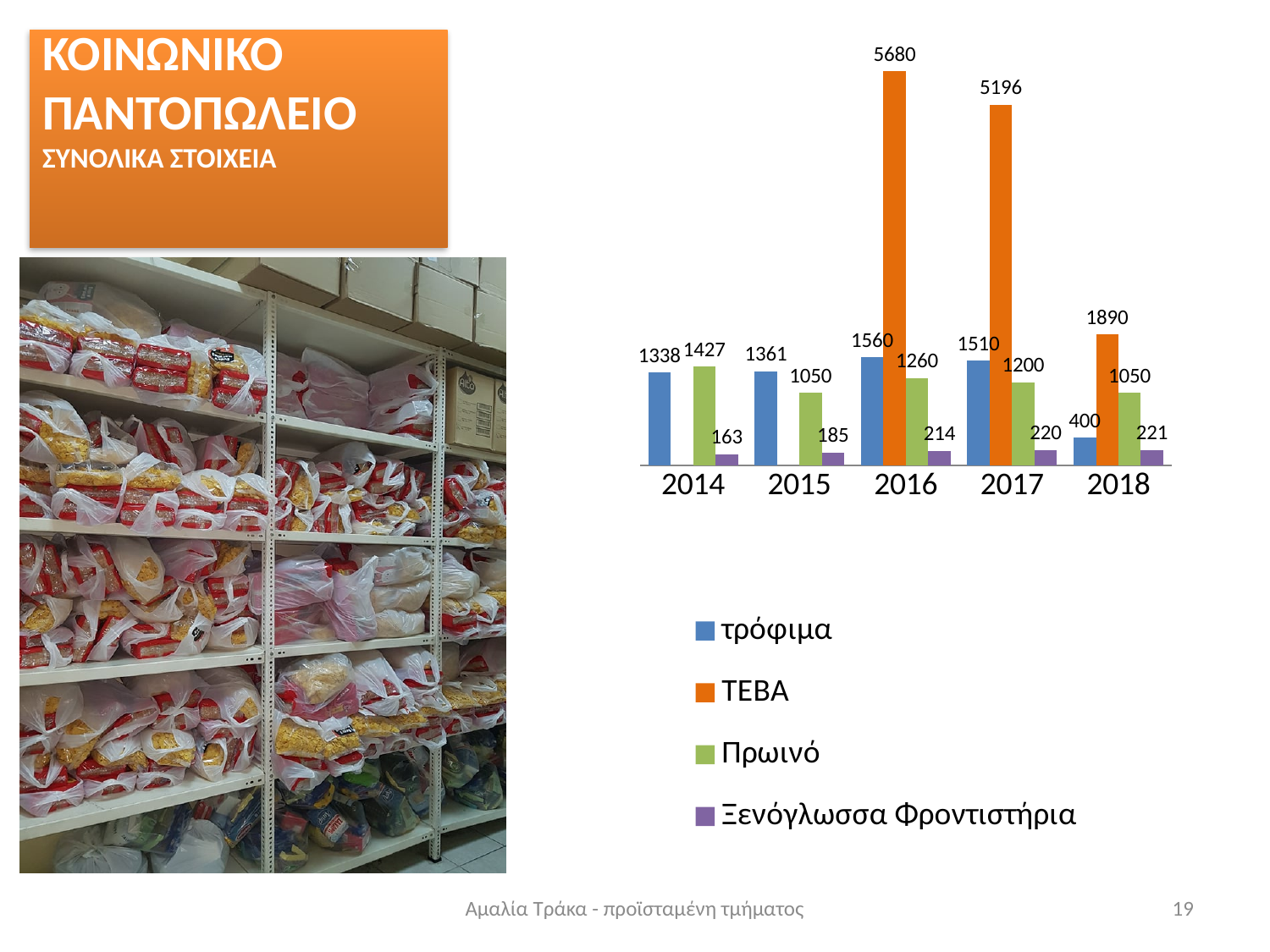
What is the value for Ξενόγλωσσα Φροντιστήρια in 2017? 220 What is the value for ΤΕΒΑ in 2016? 5680 What is the difference between the ΤΕΒΑ values for 2016 and 2017? 484 What is the value for Πρωινό in 2014? 1427 How many series does the chart legend list? 4 How many years are shown on the x axis of the chart? 5 In which year is the τρόφιμα value lowest? 2018 What type of chart is shown on the slide? bar chart Do the Ξενόγλωσσα Φροντιστήρια values rise or fall from 2014 to 2018? rise What is the value for τρόφιμα in 2018? 400 In which year is the ΤΕΒΑ value highest? 2016 Which is larger, the τρόφιμα value for 2015 or the Πρωινό value for 2015? τρόφιμα (1361)